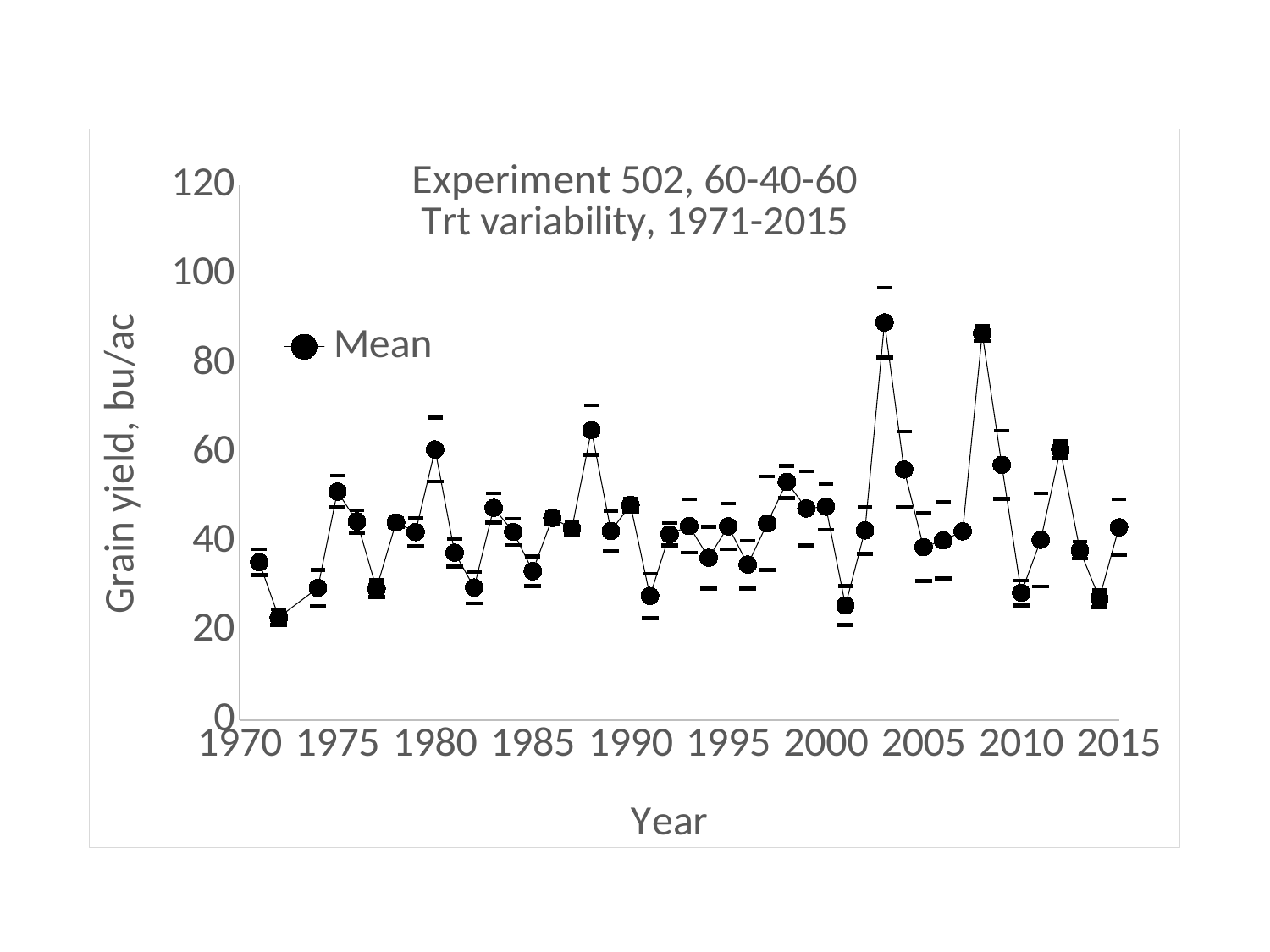
Is the mean grain yield for 2003 greater or less than 80? greater Which year has the larger mean grain yield, 1980 or 1982? 1980 How many series does the legend list? 1 Is the mean grain yield for 2001 greater or less than 40? less Is the mean grain yield for 1980 greater or less than 40? greater What is the title of the chart? Experiment 502, 60-40-60 Trt variability, 1971-2015 What kind of chart is shown on the slide? line chart Which year has the larger mean grain yield, 1988 or 1991? 1988 Which year has the larger mean grain yield, 2003 or 1972? 2003 What is the label of the y axis? Grain yield, bu/ac